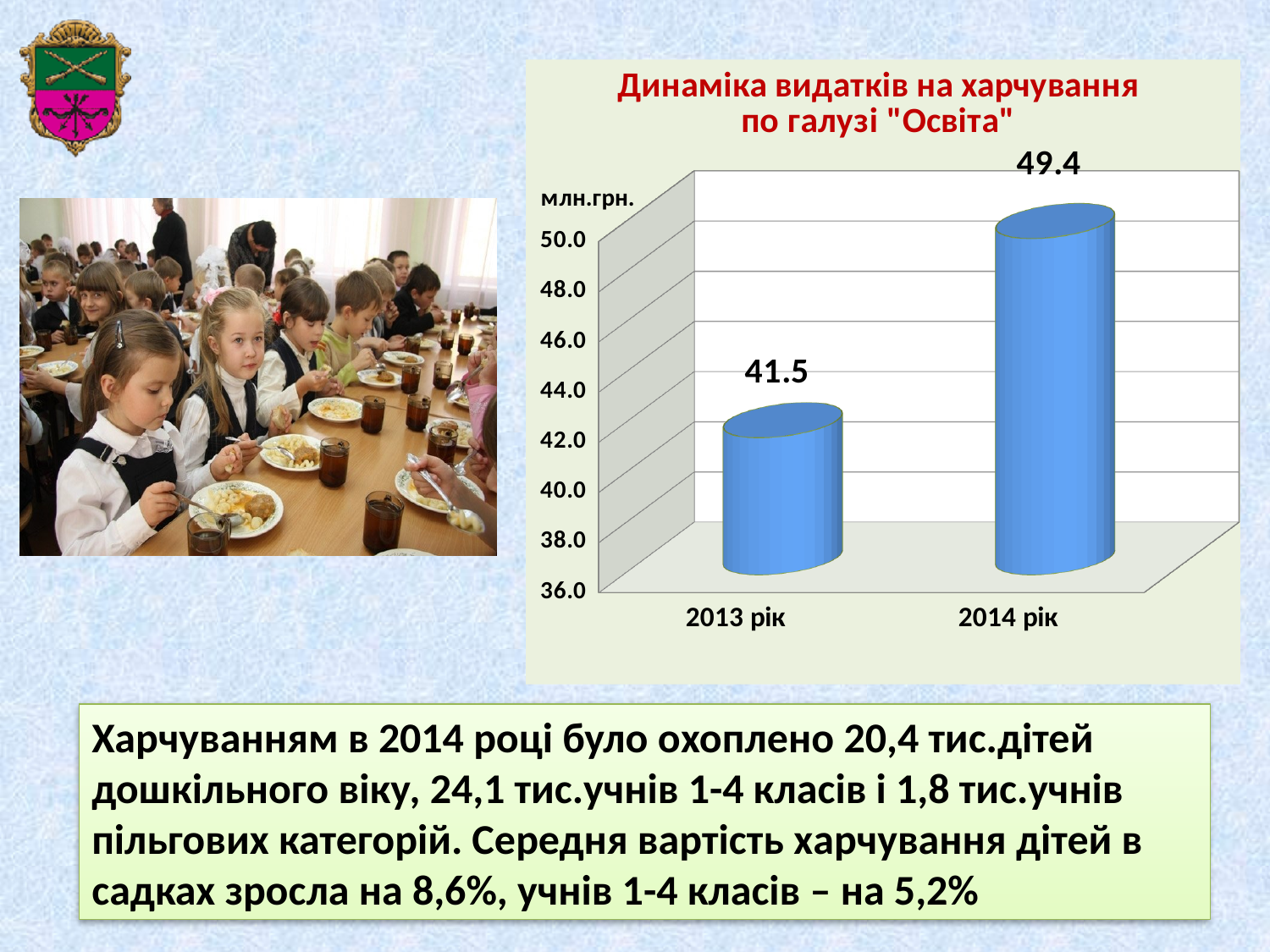
What is the difference between the values for 2014 рік and 2013 рік? 7.9 What is the value for 2013 рік? 41.5 Do the values rise or fall from 2013 рік to 2014 рік? rise Is the value for 2013 рік greater or less than 44.0? less Which is larger, the value for 2013 рік or 2014 рік? 2014 рік Is the value for 2014 рік greater or less than 46.0? greater Which year has the lowest value? 2013 рік Which year has the highest value? 2014 рік What unit is shown on the chart's vertical axis? млн.грн. How many categories are shown on the chart? 2 What kind of chart is shown on the slide? bar chart What is the value for 2014 рік? 49.4